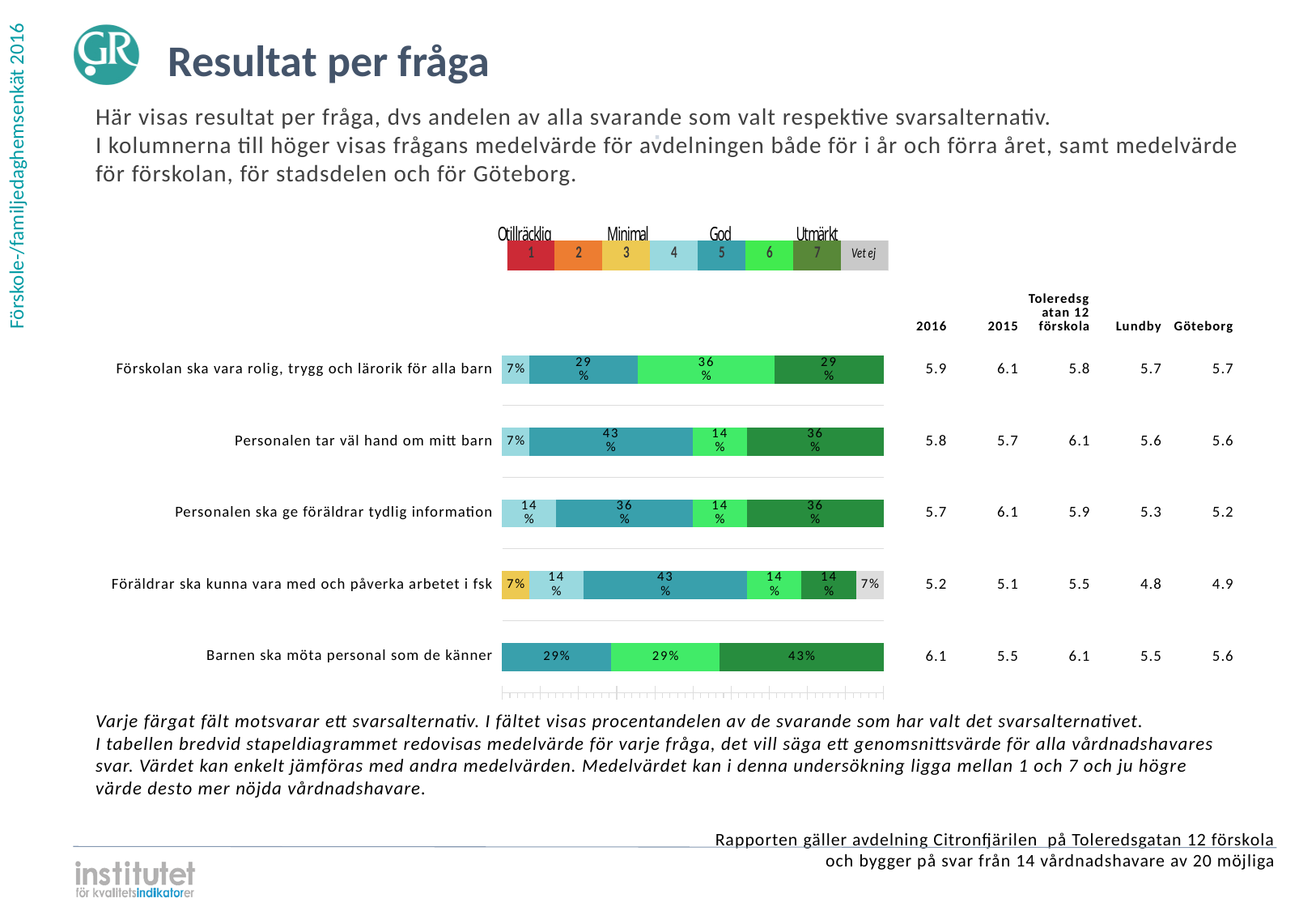
What percentage answered 'Vet ej' for 'Föräldrar ska kunna vara med och påverka arbetet i fsk'? 7% What percentage chose alternative 7 (dark green) for 'Barnen ska möta personal som de känner'? 43% Which answer alternative has the largest share for 'Föräldrar ska kunna vara med och påverka arbetet i fsk'? 5 (43%) For 'Personalen ska ge föräldrar tydlig information', which is larger: the share for alternative 5 or the share for alternative 4? Alternative 5 (36%) Which question has the lowest 2016 mean value in the table? Föräldrar ska kunna vara med och påverka arbetet i fsk (5.2) What is the difference between the share for alternative 5 and the share for alternative 6 for 'Personalen tar väl hand om mitt barn'? 29% What kind of chart is used to show the results per question on this slide? Stacked bar chart How many answer alternatives does the legend above the chart list, including 'Vet ej'? 8 What percentage of respondents chose alternative 6 (light green) for 'Förskolan ska vara rolig, trygg och lärorik för alla barn'? 36% What percentage chose alternative 7 (dark green) for 'Personalen tar väl hand om mitt barn'? 36% How many questions (categories) are shown as bars in the chart? 5 What is the 2016 mean value for 'Barnen ska möta personal som de känner'? 6.1